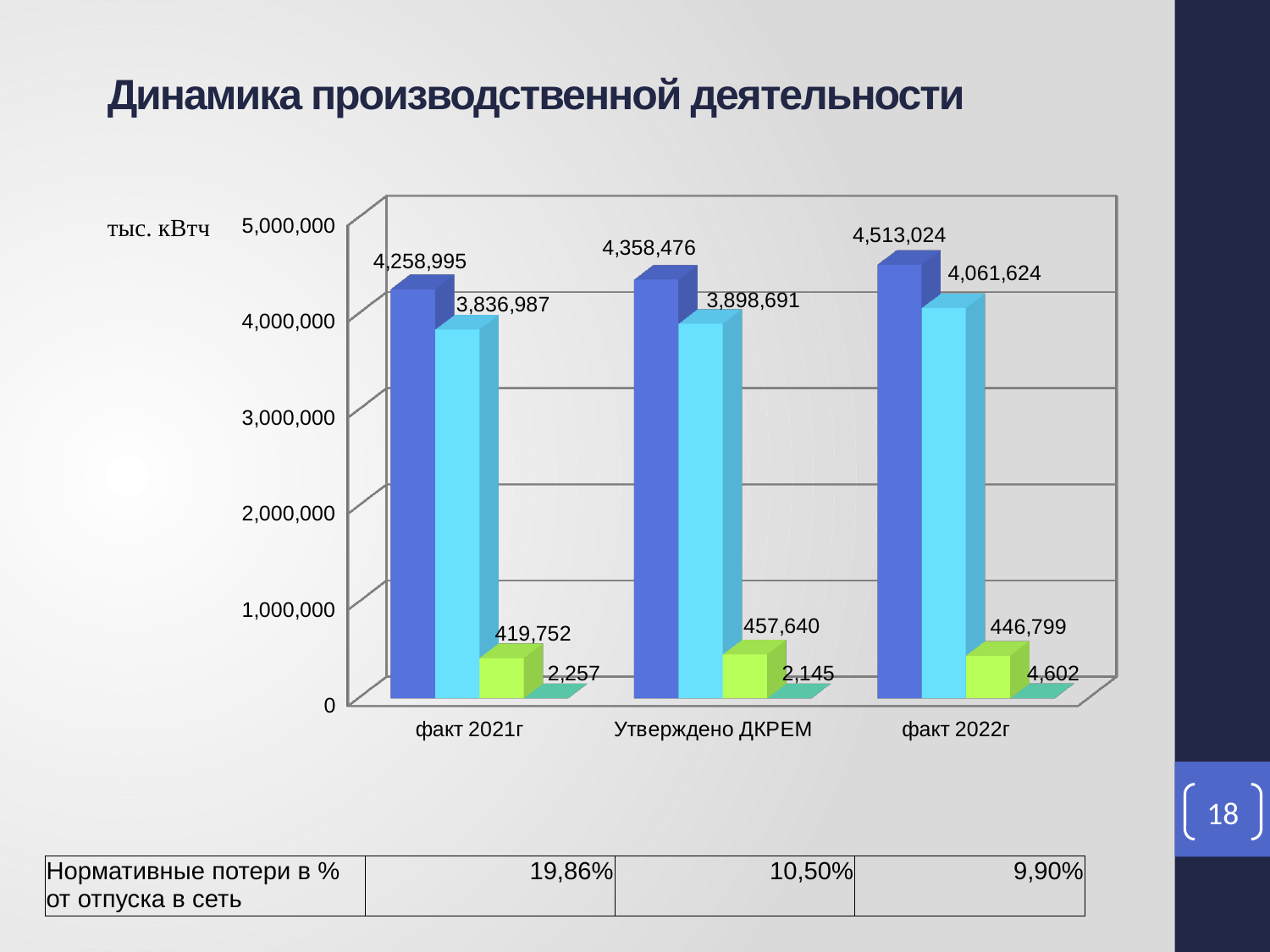
For which category is the green bar lowest? факт 2021г What is the value of the light blue bar for Утверждено ДКРЕМ? 3,898,691 For which category is the dark blue bar highest? факт 2022г Which is larger: the green bar for Утверждено ДКРЕМ or the green bar for факт 2022г? Утверждено ДКРЕМ What is the value of the dark blue bar for факт 2021г? 4,258,995 How many categories are shown on the x axis? 3 What is the difference between the light blue bar values for факт 2022г and факт 2021г? 224,637 What is the difference between the dark blue bar values for факт 2022г and факт 2021г? 254,029 What is the value of the smallest (teal) bar for факт 2021г? 2,257 Do the dark blue bar values rise or fall from факт 2021г to факт 2022г? rise What is the value of the green bar for факт 2022г? 446,799 What kind of chart is shown on the slide? bar chart